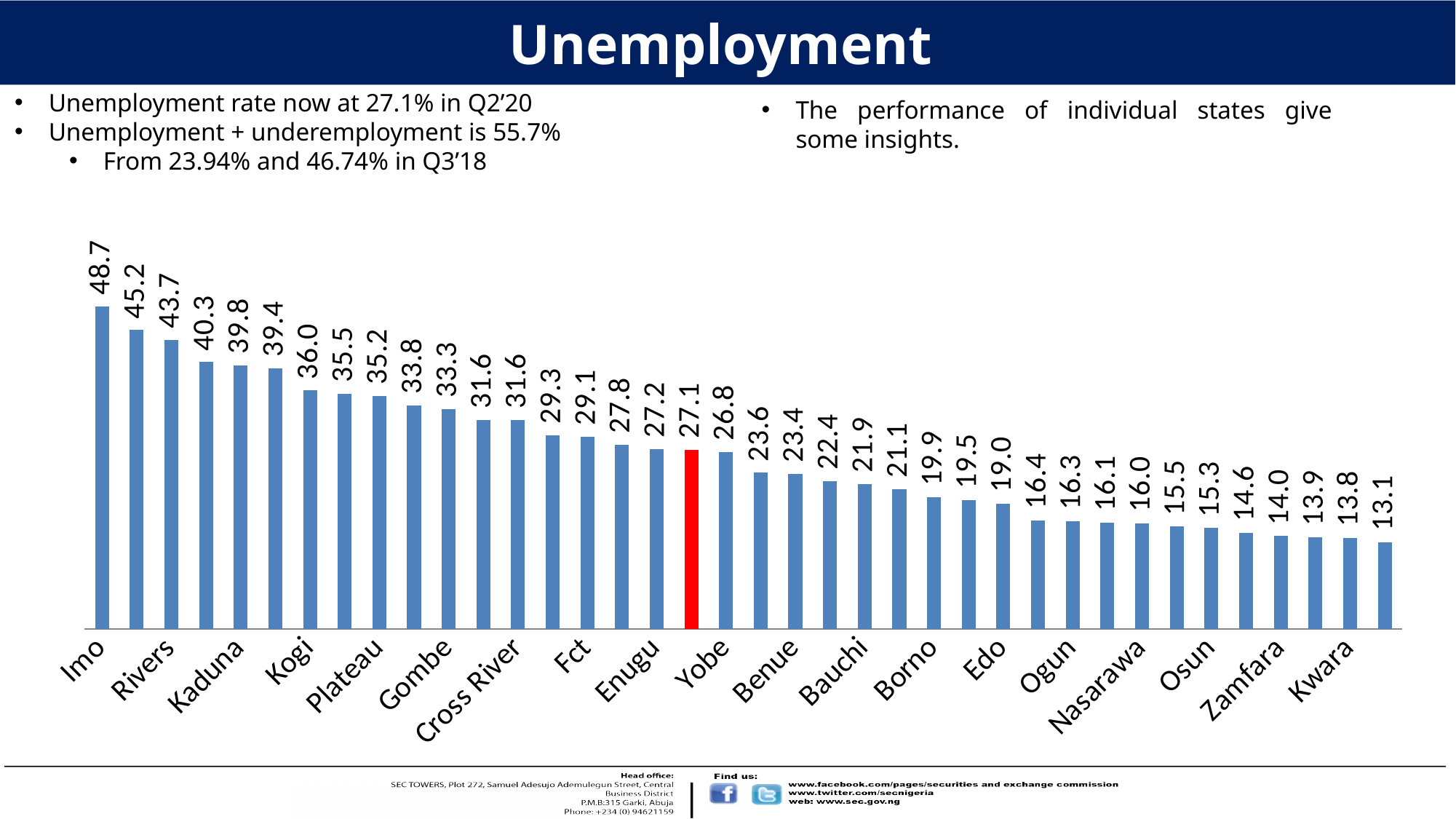
What is the difference between the highest value (48.7) and the lowest value (13.1) in the chart? 35.6 Which state has the highest unemployment rate in the chart? Imo What is the unemployment rate shown for Imo? 48.7 What kind of chart is shown on the slide? bar chart What is the lowest value shown in the chart? 13.1 What is the unemployment rate shown for Benue? 23.4 Do the values rise or fall moving from left to right along the x axis? fall What value is shown on the red bar in the chart? 27.1 What is the unemployment rate shown for Edo? 19.0 What is the unemployment rate shown for Yobe? 26.8 Which is larger, the value for Imo or the value for Kwara? Imo What colour is the bar that is highlighted differently from the others? red